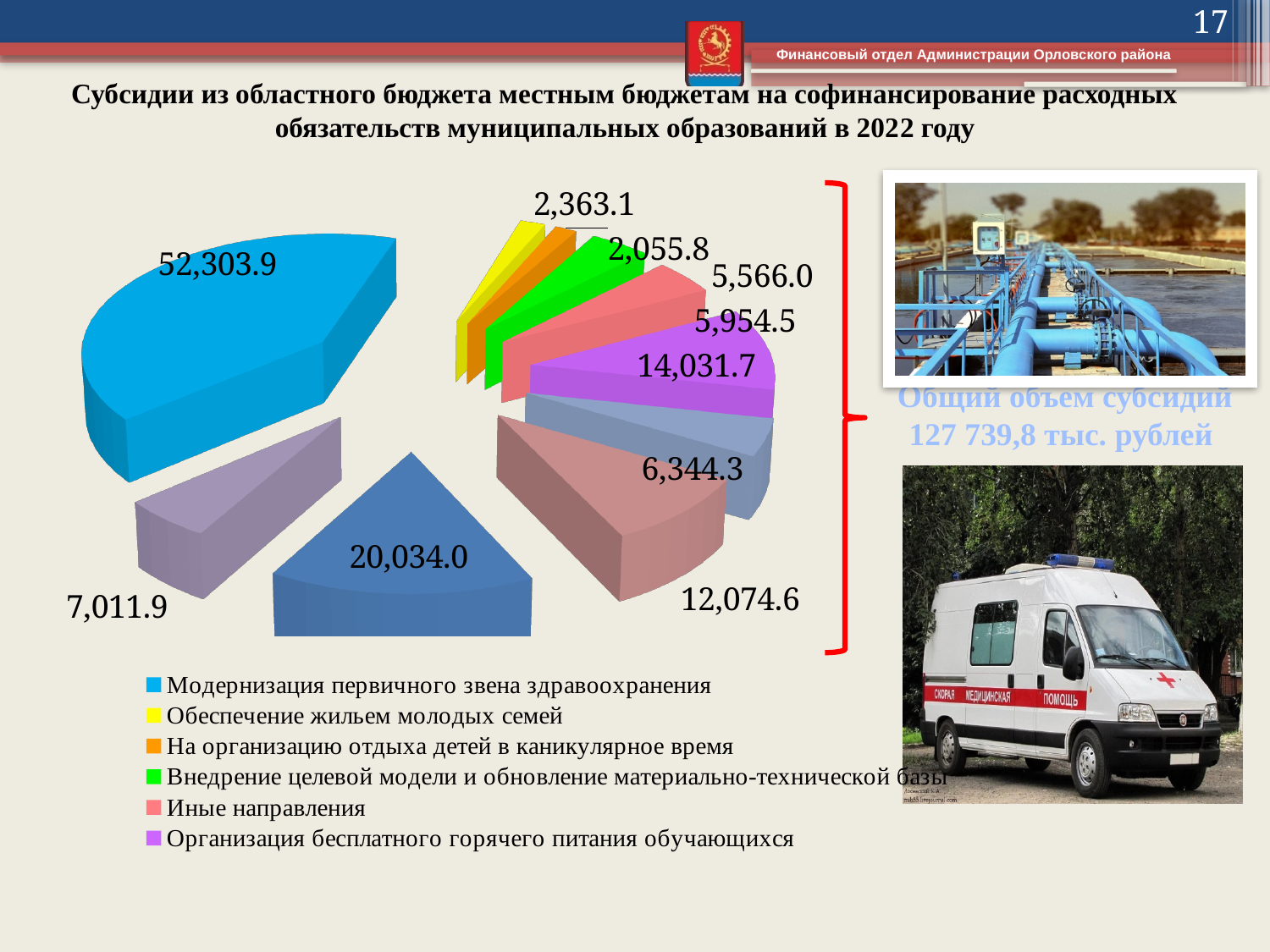
How many slices does the pie chart have? 10 What is the value of the largest slice in the pie chart? 52,303.9 Which category does the largest slice of the pie chart represent? Модернизация первичного звена здравоохранения What is the difference between the slice labelled 52,303.9 and the slice labelled 20,034.0? 32,269.9 What value is shown for Модернизация первичного звена здравоохранения? 52,303.9 What colour is the slice for Модернизация первичного звена здравоохранения? blue How many entries does the legend of the pie chart list? 6 What kind of chart is shown on the slide? pie chart What is the total volume of subsidies stated on the slide? 127 739,8 тыс. рублей What value is shown for Организация бесплатного горячего питания обучающихся (the purple slice)? 14,031.7 What is the value of the smallest slice in the pie chart? 2,055.8 Which is larger: the slice labelled 14,031.7 or the slice labelled 12,074.6? 14,031.7